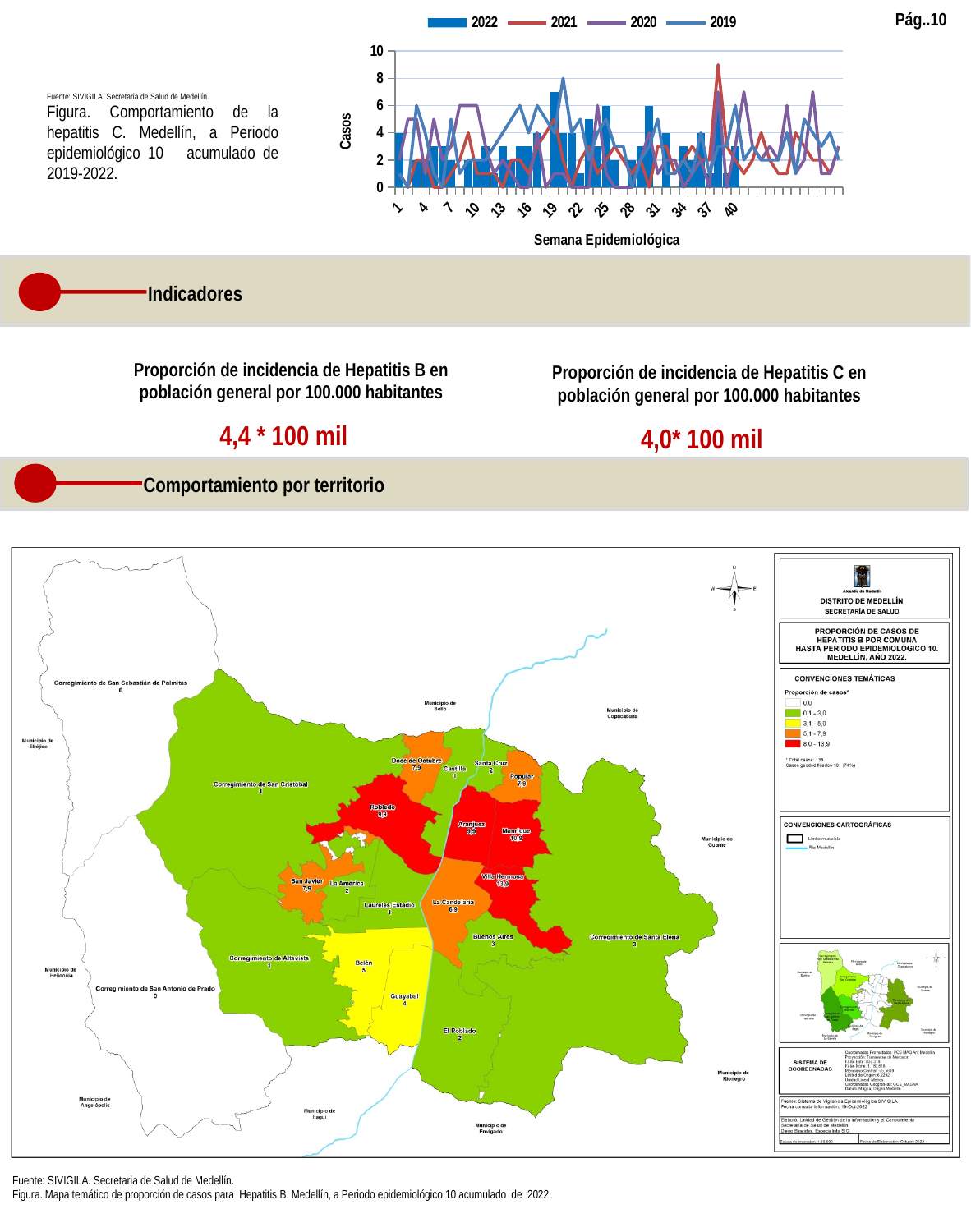
Which years are listed in the legend of the hepatitis C chart? 2022, 2021, 2020, 2019 What is the highest tick value shown on the vertical axis of the hepatitis C chart? 10 In the hepatitis C chart, is the 2022 bar at week 19 greater or less than 6? greater What is the label of the vertical axis of the hepatitis C chart? Casos How many series does the legend of the hepatitis C chart list? 4 In the hepatitis C chart, is the 2022 bar at week 1 greater or less than 6? less In the hepatitis C chart, is the peak value of the 2021 line greater or less than 8? greater What kind of chart is shown at the top of the slide for hepatitis C cases? A combined bar and line chart In the hepatitis C chart, which series reaches the highest single value? 2021